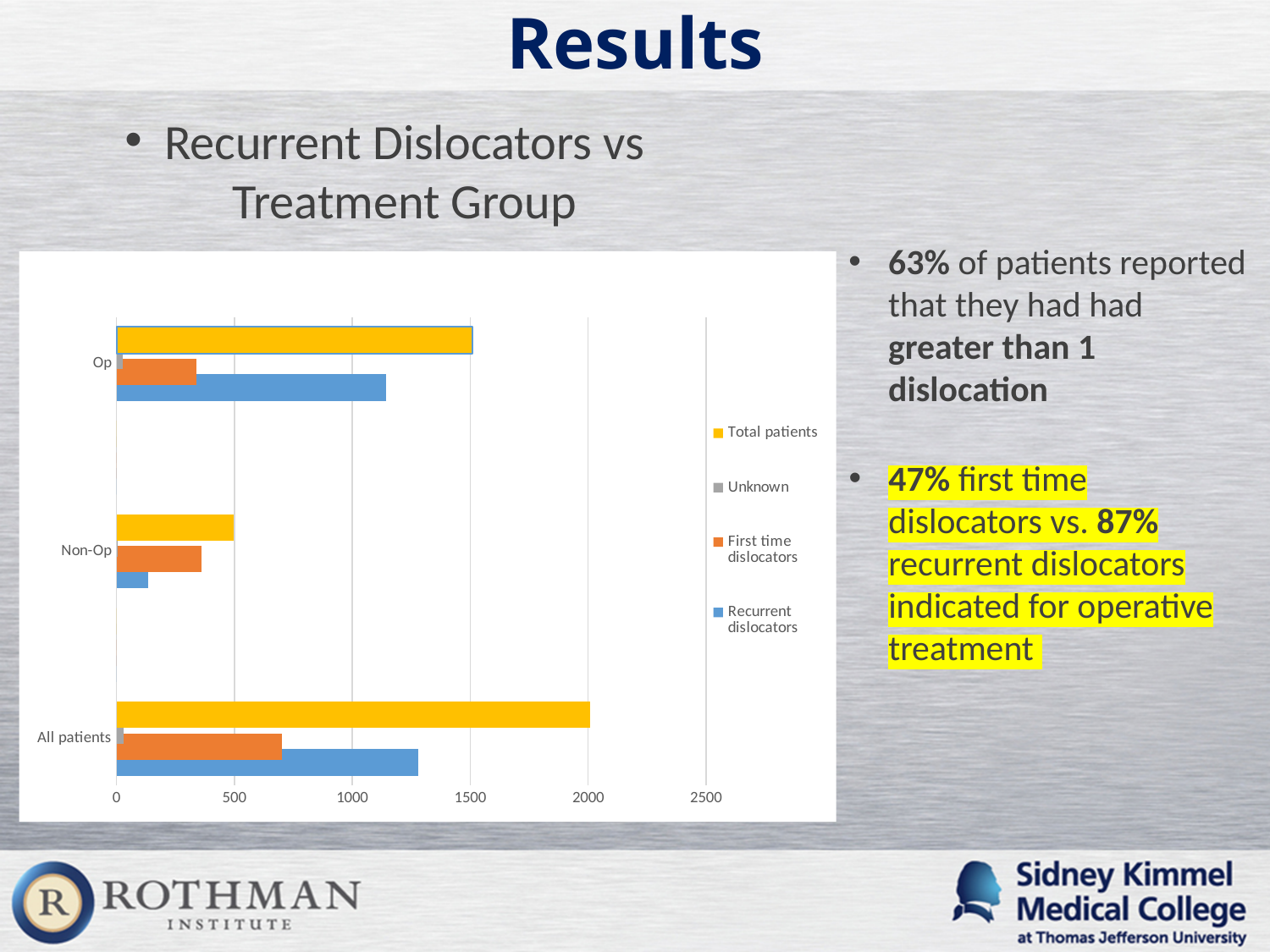
How many series does the chart legend list? 4 Is the value for Recurrent dislocators in the Op group greater or less than 1000? greater Is the value for Recurrent dislocators in the Non-Op group greater or less than 500? less Is the value for First time dislocators in the All patients group greater or less than 500? greater Which category has the lowest value for Total patients? Non-Op In the Op group, which is larger: Recurrent dislocators or First time dislocators? Recurrent dislocators In the Non-Op group, which is larger: First time dislocators or Recurrent dislocators? First time dislocators Which category has the highest value for Total patients? All patients How many categories are shown on the vertical axis of the chart? 3 What kind of chart is shown on the slide? bar chart Which colour represents the Total patients series in the chart? yellow